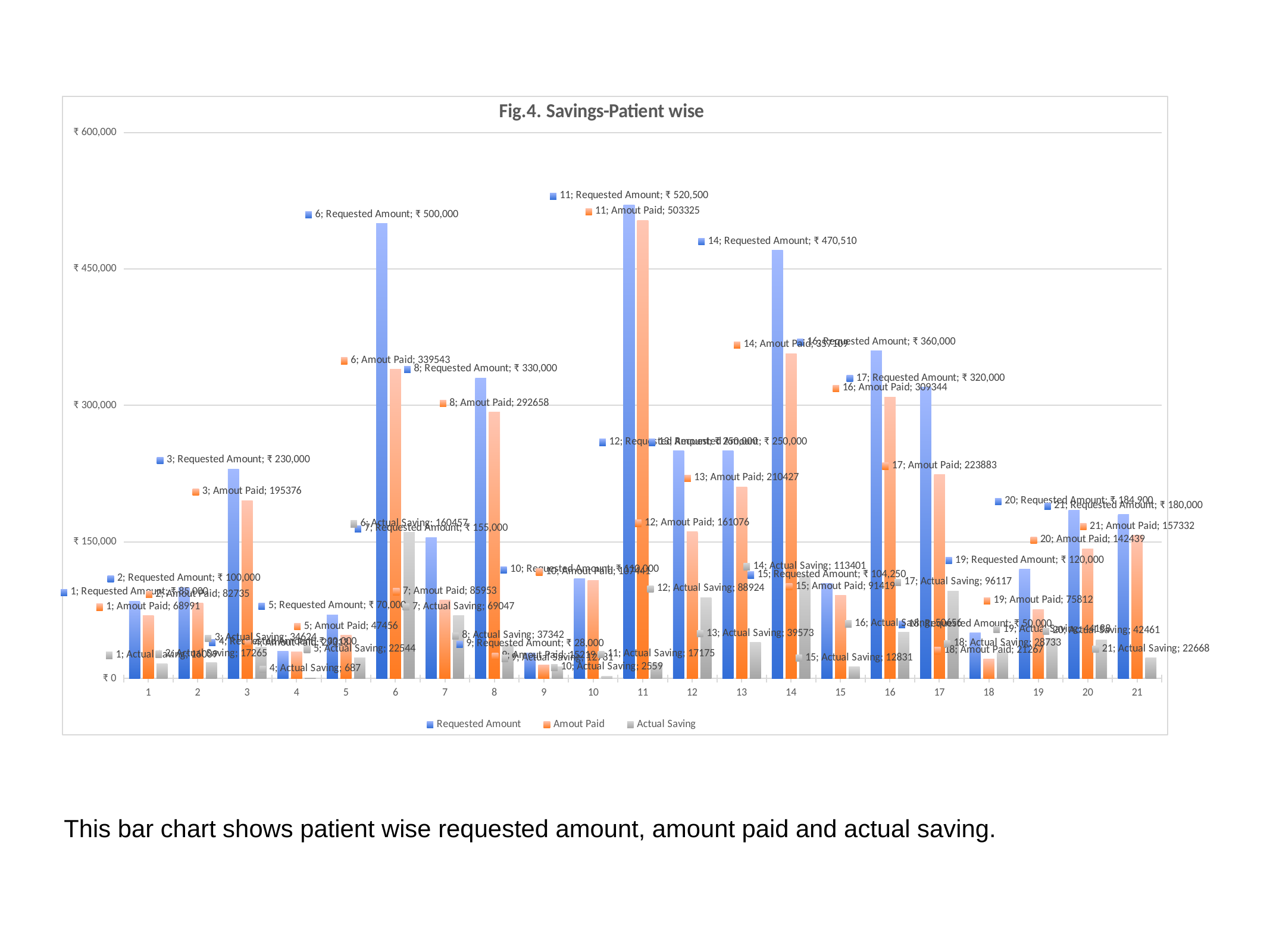
Which patient has the lowest Actual Saving? 4 Which patient has the highest Requested Amount? 11 What is the difference between the Requested Amount and the Amount Paid for patient 8? 37342 Is the Requested Amount for patient 16 greater or less than ₹ 300,000? greater What type of chart is shown on the slide? bar chart What is the Amount Paid for patient 6? 339543 How many series does the legend list? 3 How many patients (categories) are shown on the x axis? 21 What is the title of the chart? Fig.4. Savings-Patient wise What is the Actual Saving for patient 17? 96117 What is the Requested Amount for patient 11? ₹ 520,500 Which is larger: the Requested Amount for patient 6 or the Requested Amount for patient 14? patient 6